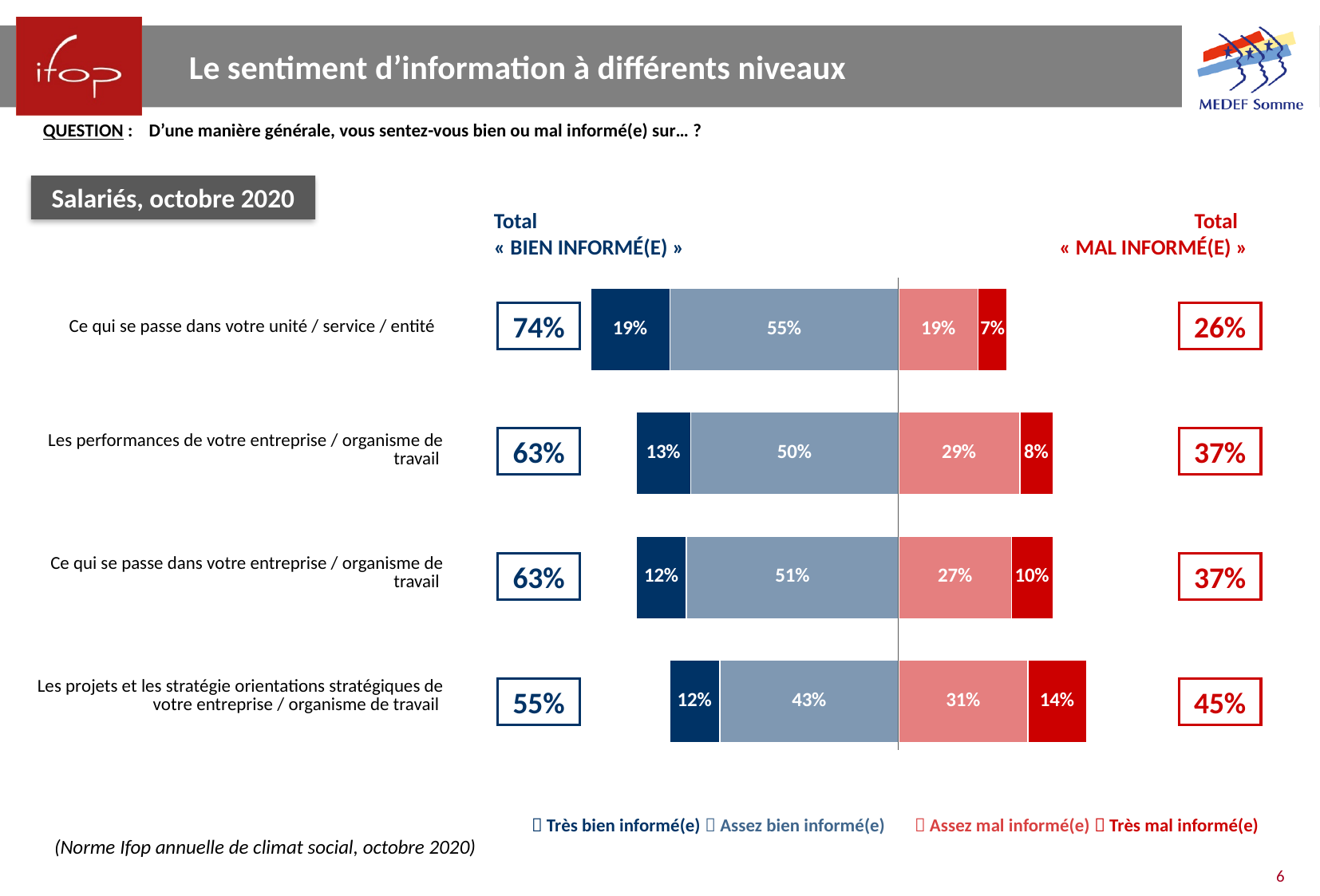
What kind of chart is shown on the slide? Stacked bar chart Which category has the highest Total « BIEN INFORMÉ(E) » value? Ce qui se passe dans votre unité / service / entité Which is larger: the 'Assez bien informé(e)' value for 'Ce qui se passe dans votre unité / service / entité' or for 'Les projets et les orientations stratégiques'? Ce qui se passe dans votre unité / service / entité What is the Total « MAL INFORMÉ(E) » value for 'Les performances de votre entreprise / organisme de travail'? 37% Which category has the highest 'Très mal informé(e)' value? Les projets et les orientations stratégiques de votre entreprise / organisme de travail How many categories (items) are plotted in the chart? 4 What is the 'Assez bien informé(e)' value for 'Les performances de votre entreprise / organisme de travail'? 50% What is the 'Très mal informé(e)' value for 'Les projets et les orientations stratégiques de votre entreprise / organisme de travail'? 14% How many series does the legend list? 4 What is the difference between the Total « MAL INFORMÉ(E) » values for 'Les projets et les orientations stratégiques' and 'Ce qui se passe dans votre unité / service / entité'? 19% What is the 'Très bien informé(e)' value for 'Ce qui se passe dans votre unité / service / entité'? 19% What is the 'Assez mal informé(e)' value for 'Ce qui se passe dans votre entreprise / organisme de travail'? 27%